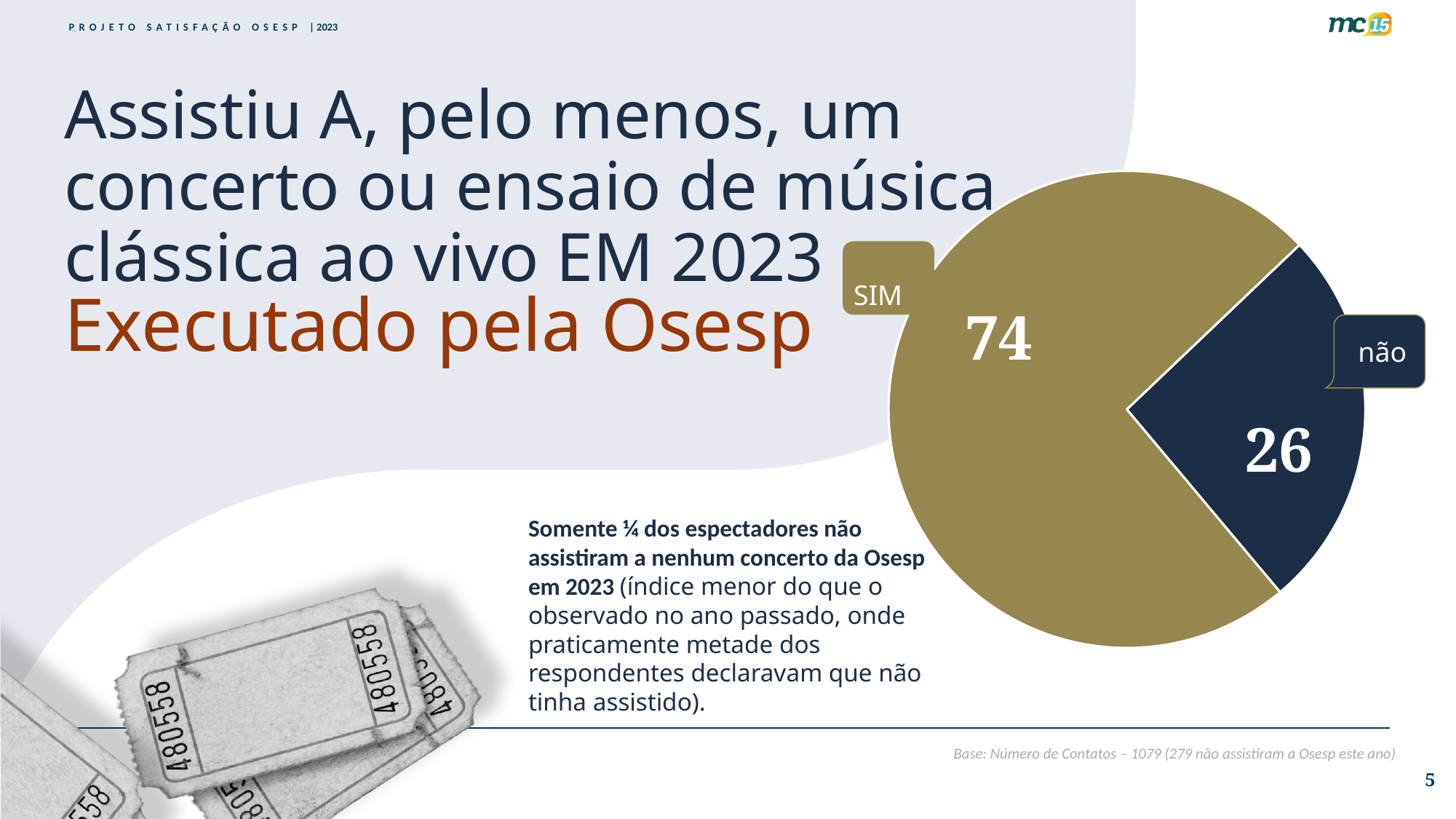
What colour is the não slice of the pie chart? dark navy blue What kind of chart is shown on the slide? pie chart Which slice of the pie chart is the smallest? não What is the total of the two slices in the pie chart? 100 Which is larger in the pie chart, SIM or não? SIM What is the value for SIM in the pie chart? 74 What is the difference between the SIM and não values in the pie chart? 48 Which slice of the pie chart is the largest? SIM How many slices does the pie chart have? 2 What is the value for não in the pie chart? 26 What colour is the SIM slice of the pie chart? olive/gold